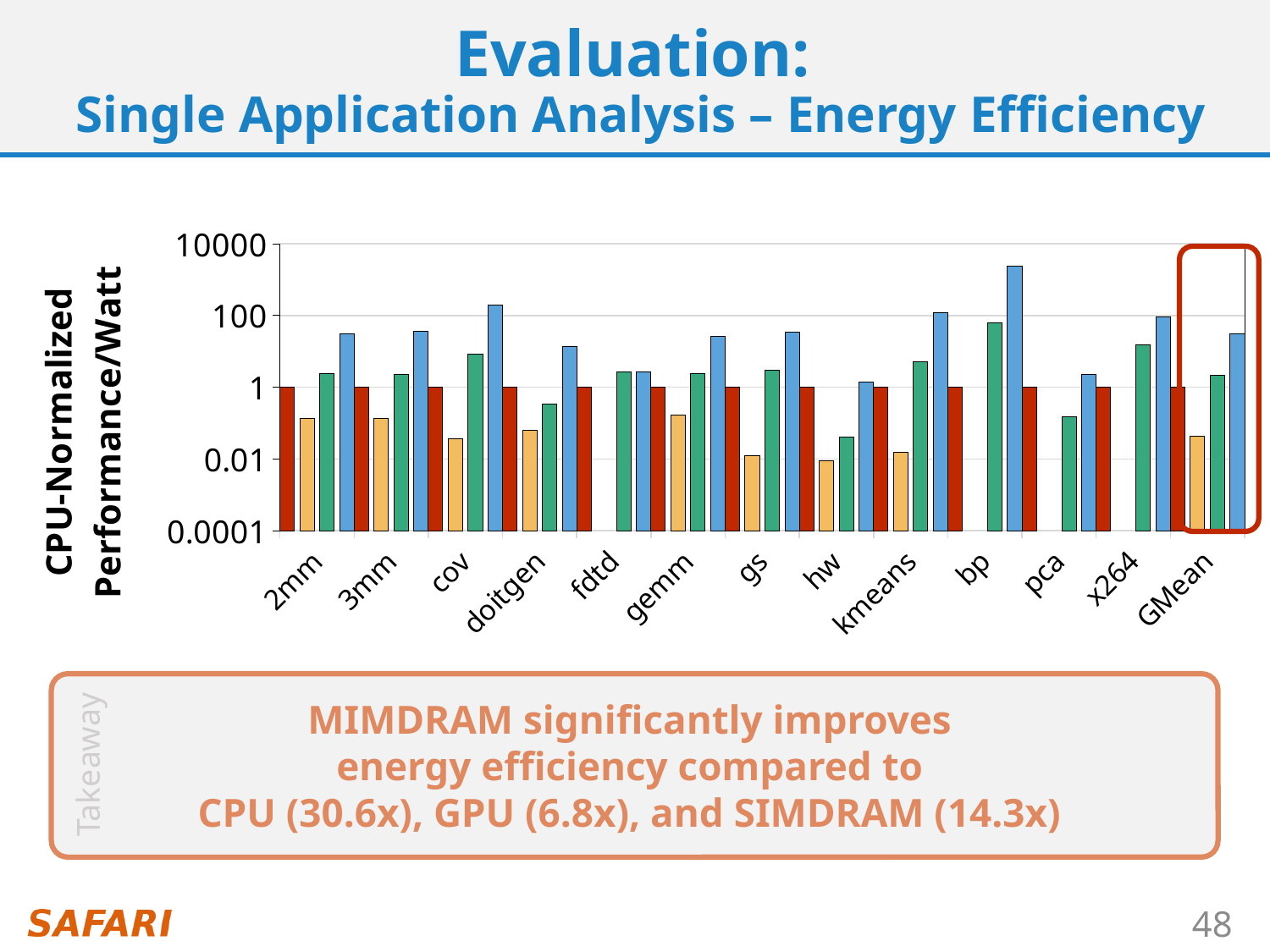
Is the value of the blue bar for bp greater or less than 100? greater Is the value of the blue bar for doitgen greater or less than 100? less Which category on the x axis is highlighted with a red box? GMean What is the value of the red bar for 2mm? 1 Is the value of the green bar for pca greater or less than 1? less How many categories are shown along the x axis of the chart? 13 Which category has the highest blue bar? bp What kind of chart is shown on the slide? bar chart Which is larger, the blue bar for bp or the blue bar for 2mm? bp What is the label of the y axis of the chart? CPU-Normalized Performance/Watt